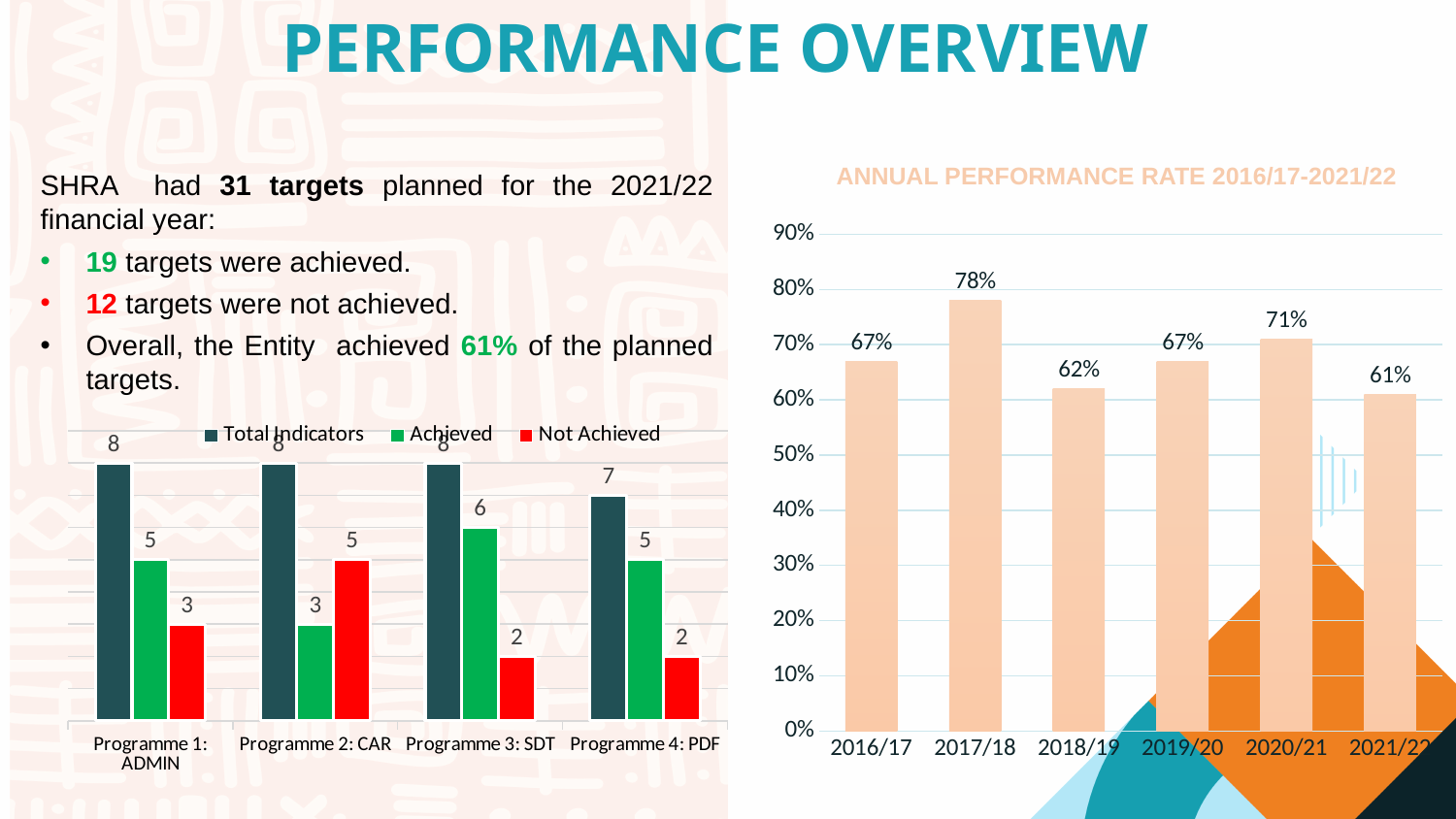
What kind of chart is the 'ANNUAL PERFORMANCE RATE 2016/17-2021/22' chart? bar chart In the chart on the left of the slide, how many targets were Achieved for Programme 3: SDT? 6 In the 'ANNUAL PERFORMANCE RATE 2016/17-2021/22' chart, what is the difference between the 2017/18 and 2018/19 values? 16% In the 'ANNUAL PERFORMANCE RATE 2016/17-2021/22' chart, which year has the highest performance rate? 2017/18 In the 'ANNUAL PERFORMANCE RATE 2016/17-2021/22' chart, what is the value for 2017/18? 78% In the chart on the left of the slide, what is the difference between Achieved and Not Achieved for Programme 1: ADMIN? 2 In the chart on the left of the slide, which programme has the highest Achieved value? Programme 3: SDT In the 'ANNUAL PERFORMANCE RATE 2016/17-2021/22' chart, is the value for 2020/21 larger or smaller than the value for 2021/22? larger In the 'ANNUAL PERFORMANCE RATE 2016/17-2021/22' chart, which year has the lowest performance rate? 2021/22 In the 'ANNUAL PERFORMANCE RATE 2016/17-2021/22' chart, how many years are plotted? 6 In the chart on the left of the slide, how many Total Indicators does Programme 4: PDF have? 7 In the chart on the left of the slide, how many series does the legend list? 3